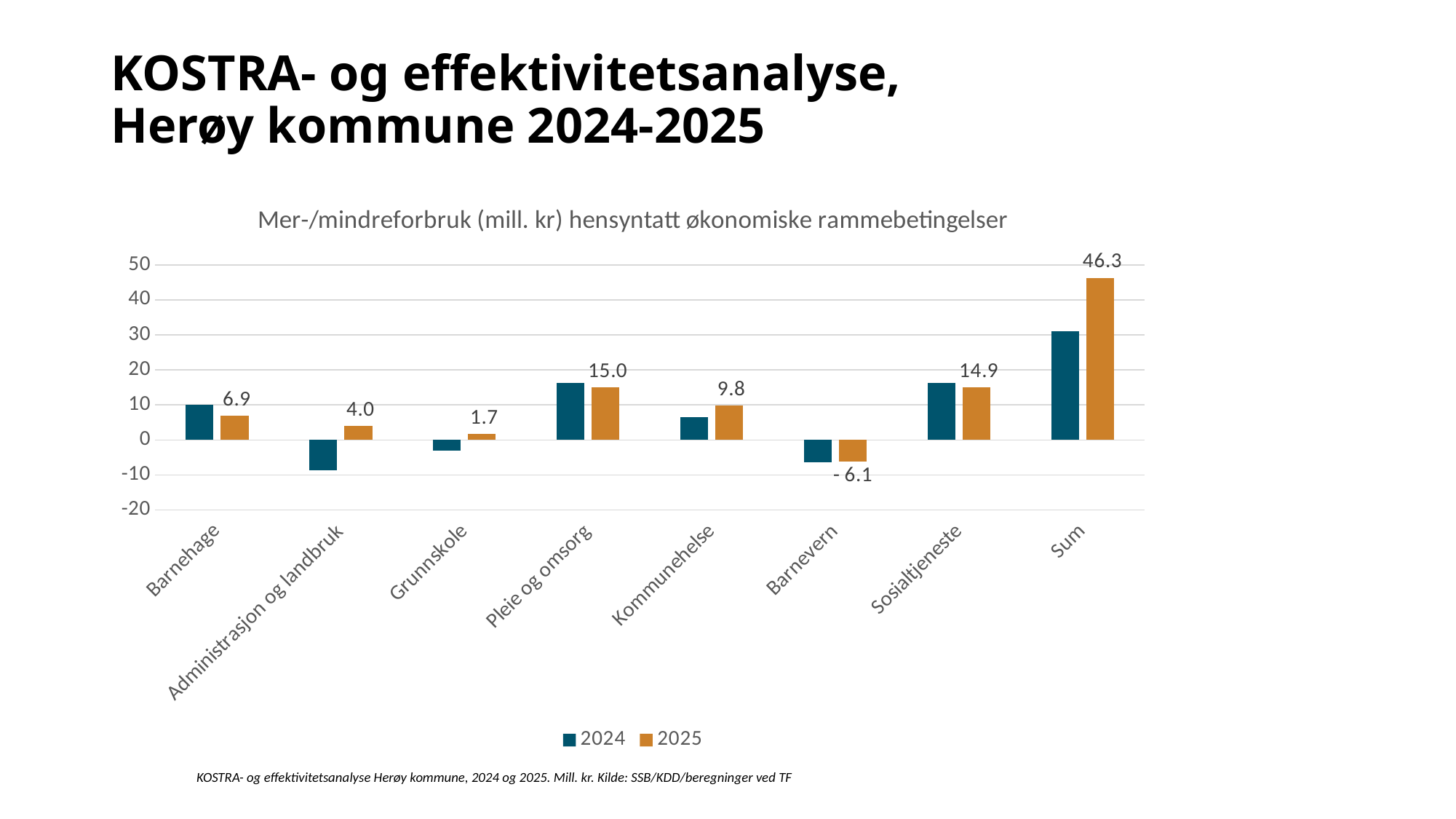
How many categories are shown on the x axis? 8 Is the 2024 value for Pleie og omsorg greater or less than 10? greater What is the difference between the 2025 values for Pleie og omsorg and Kommunehelse? 5.2 What is the 2025 value for Sum? 46.3 Which has the larger 2025 value, Barnehage or Administrasjon og landbruk? Barnehage Which category has the lowest 2025 value? Barnevern What is the 2025 value for Barnevern? - 6.1 Is the 2024 value for Administrasjon og landbruk greater or less than 0? less Which category has the highest 2025 value? Sum How many series does the legend list? 2 What is the 2025 value for Kommunehelse? 9.8 For Sum, which series has the larger value, 2024 or 2025? 2025